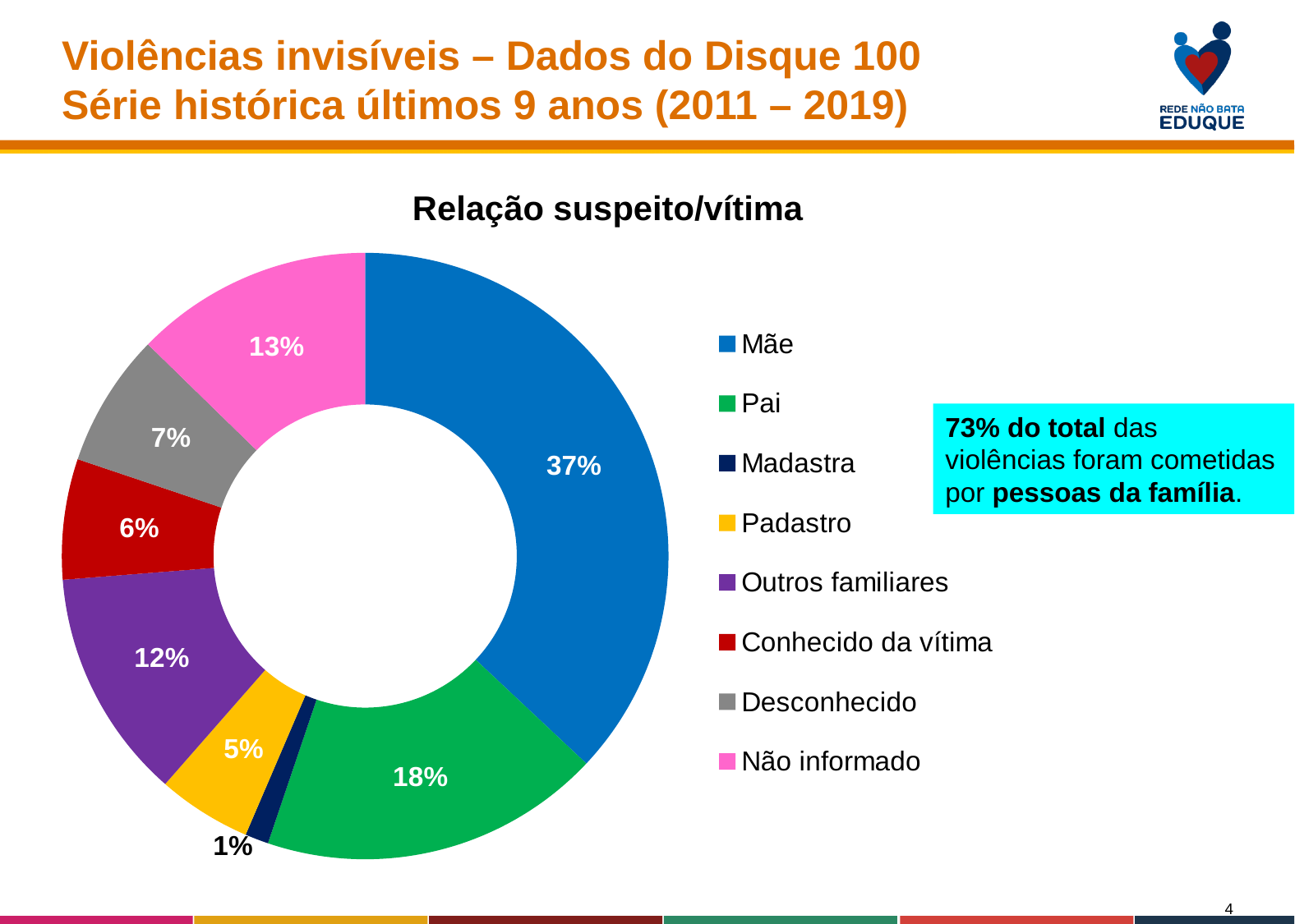
What kind of chart is shown on the slide? doughnut chart What percentage does the chart show for Outros familiares? 12% What value is shown for Não informado? 13% What percentage of the pie chart is labelled for Mãe? 37% Which is larger, the share for Desconhecido or the share for Conhecido da vítima? Desconhecido What is the difference in percentage points between Mãe and Pai? 19 How many categories are shown in the pie chart? 8 What colour is the slice for Padastro? yellow Which category has the smallest share of the pie chart? Madastra What is the title of the chart? Relação suspeito/vítima Which category has the largest share of the pie chart? Mãe What value is shown for Pai in the chart? 18%